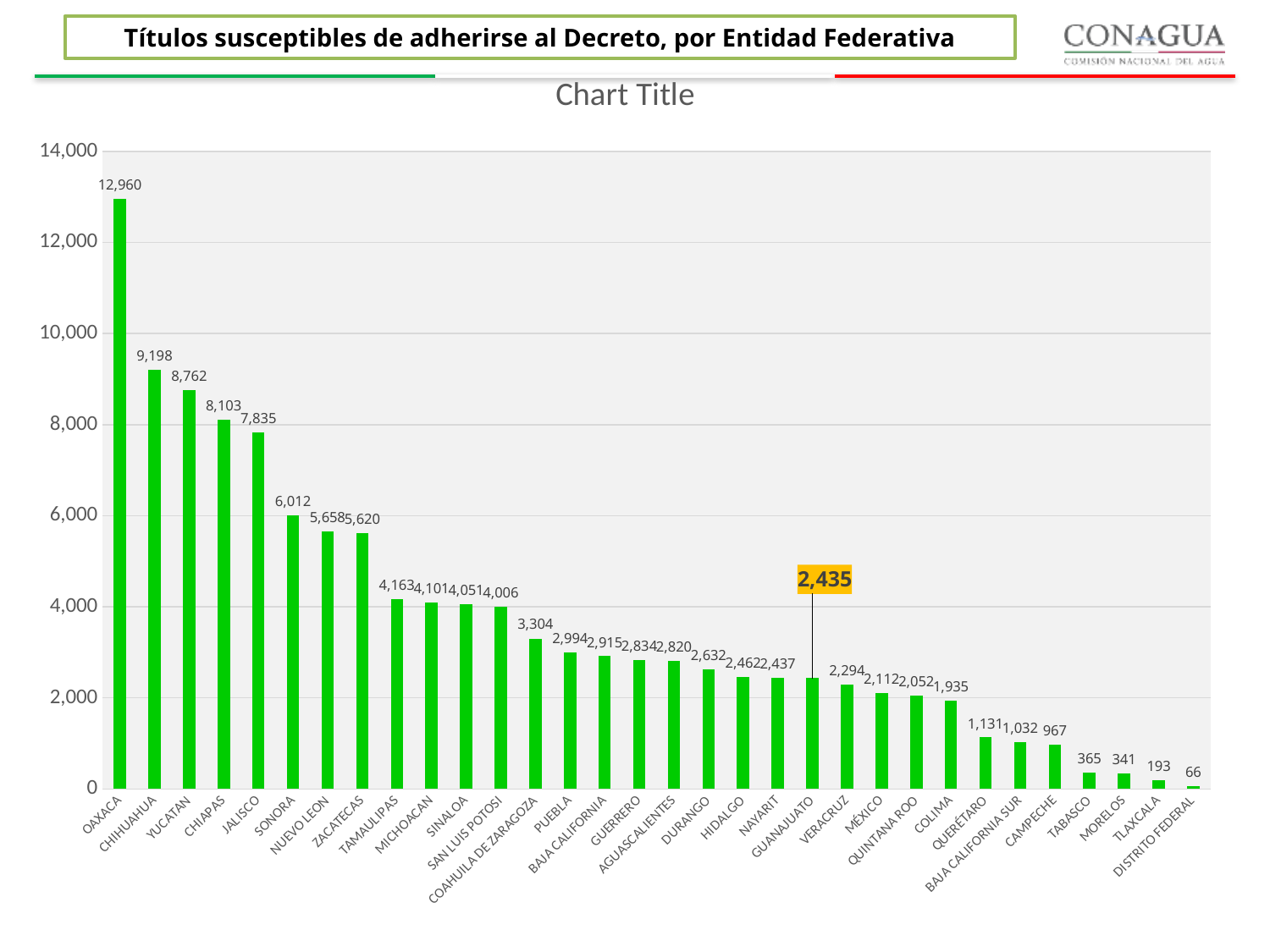
Which entity has the lowest value? DISTRITO FEDERAL What is the value for TABASCO? 365 What value is shown in the highlighted callout for GUANAJUATO? 2,435 How many entities are shown on the x axis? 32 Which entity has the highest value? OAXACA What kind of chart is this? bar chart Do the values rise or fall from left to right along the x axis? fall What is the title printed above the chart area? Chart Title What is the value for OAXACA? 12,960 Which is larger, the value for JALISCO or the value for SONORA? JALISCO Is the value for COAHUILA DE ZARAGOZA greater or less than 4,000? less What is the difference between the values for OAXACA and CHIHUAHUA? 3,762